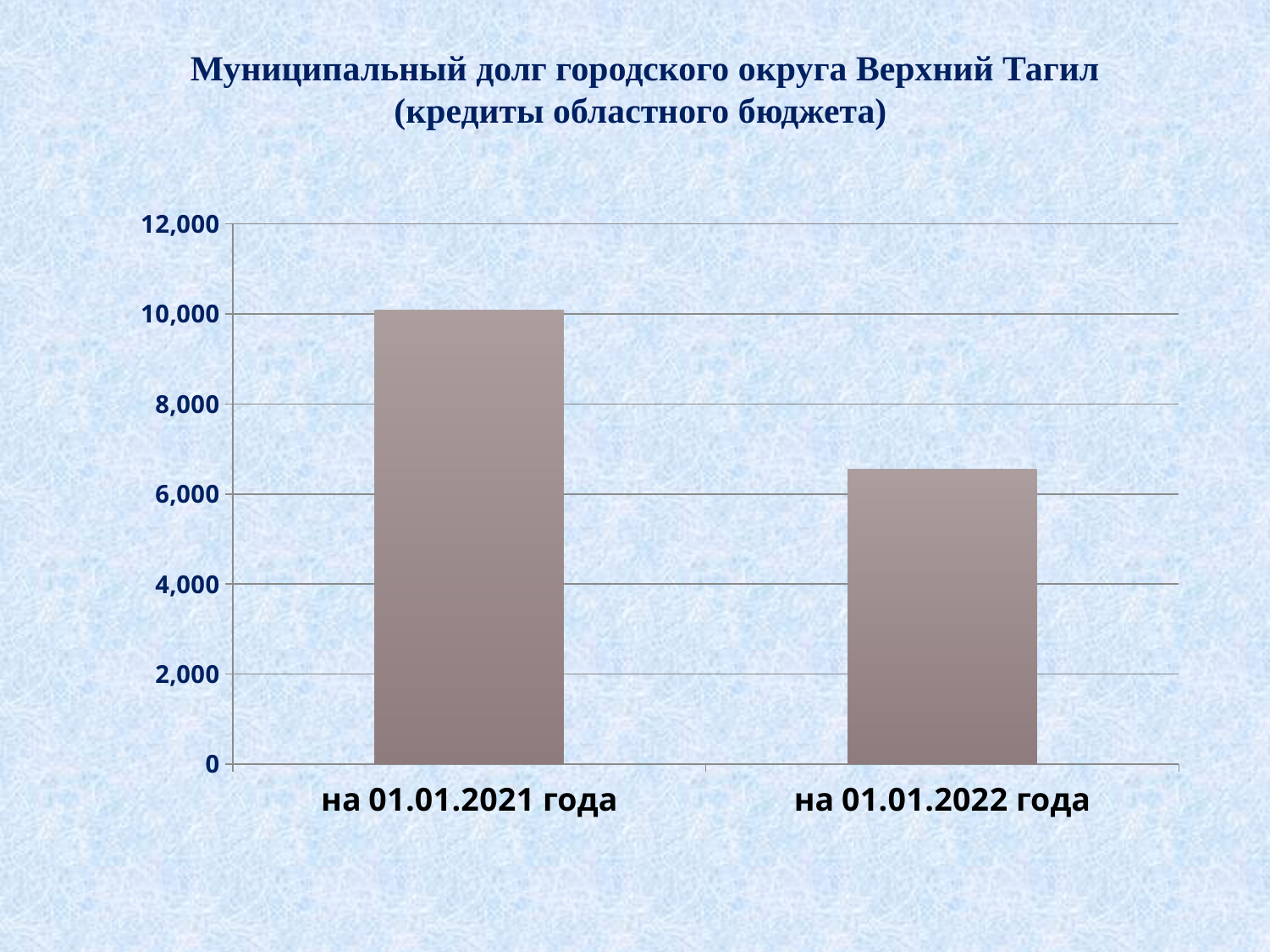
Which is larger, the value for на 01.01.2021 года or the value for на 01.01.2022 года? на 01.01.2021 года How many categories are plotted on the x axis? 2 Is the value for на 01.01.2022 года greater or less than 8,000? less What is the title of the chart? Муниципальный долг городского округа Верхний Тагил (кредиты областного бюджета) What is the highest value shown on the vertical axis? 12,000 Which category has the highest value? на 01.01.2021 года Which category has the lowest value? на 01.01.2022 года Do the values rise or fall from на 01.01.2021 года to на 01.01.2022 года? fall What kind of chart is shown on the slide? bar chart Is the value for на 01.01.2022 года greater or less than 6,000? greater Is the value for на 01.01.2021 года greater or less than 8,000? greater